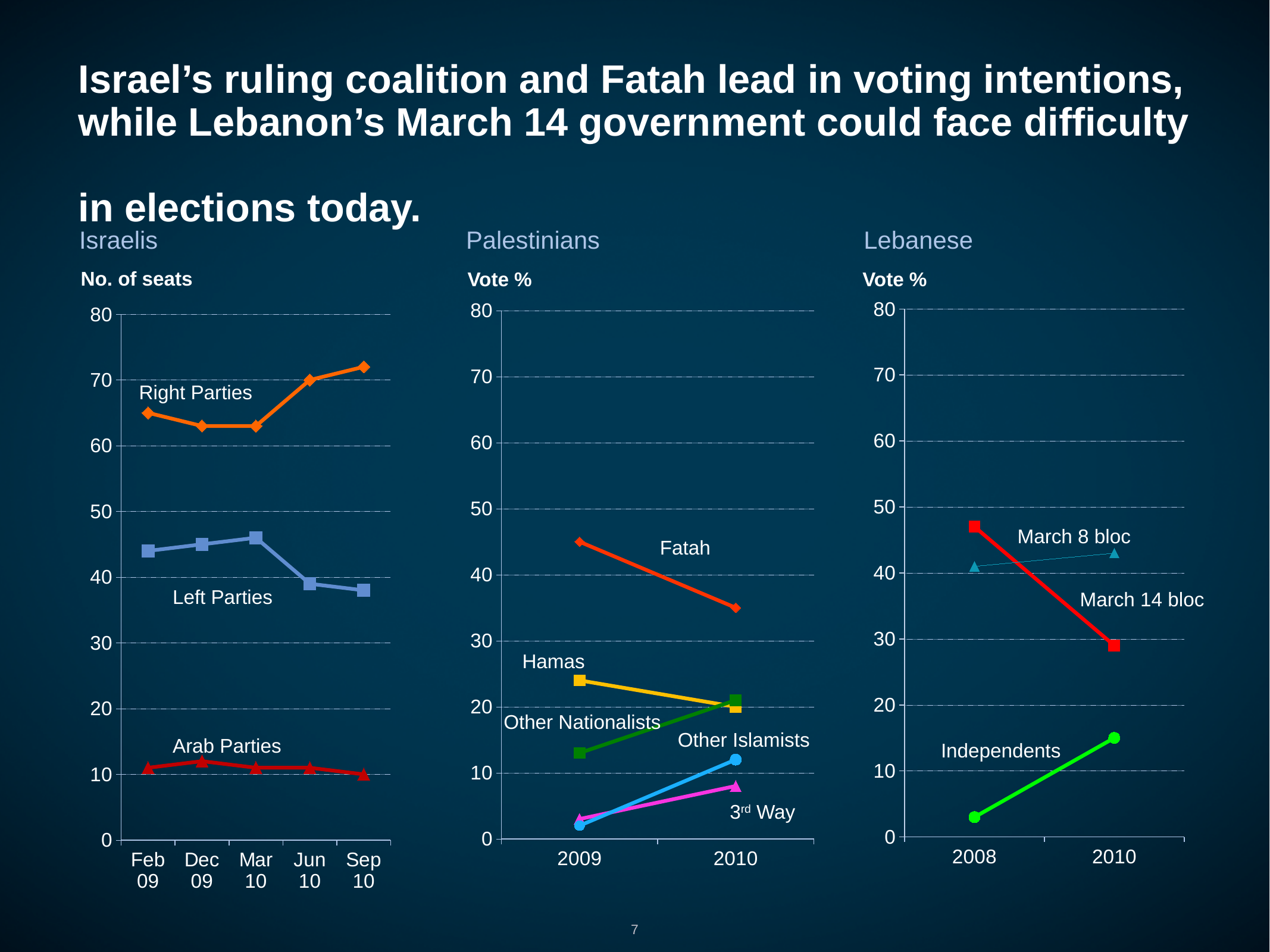
In the Palestinians chart, which is larger in 2010: Fatah or Hamas? Fatah In the Israelis chart, is the value for Left Parties in Sep 10 greater or less than 40? less In the Palestinians chart, is the value for Fatah in 2010 greater or less than 40? less In the Palestinians chart, does the Fatah line rise or fall from 2009 to 2010? fall In the Lebanese chart, is the value for Independents in 2010 greater or less than 10? greater In the Israelis chart, which party group has the lowest number of seats across all dates? Arab Parties In the Israelis chart, how many time points are shown on the x axis? 5 In the Lebanese chart, which is larger in 2010: March 8 bloc or March 14 bloc? March 8 bloc In the Israelis chart, which is larger in Sep 10: Right Parties or Left Parties? Right Parties In the Lebanese chart, does the March 14 bloc line rise or fall from 2008 to 2010? fall What type of chart is the Israelis chart on the left of the slide? line chart